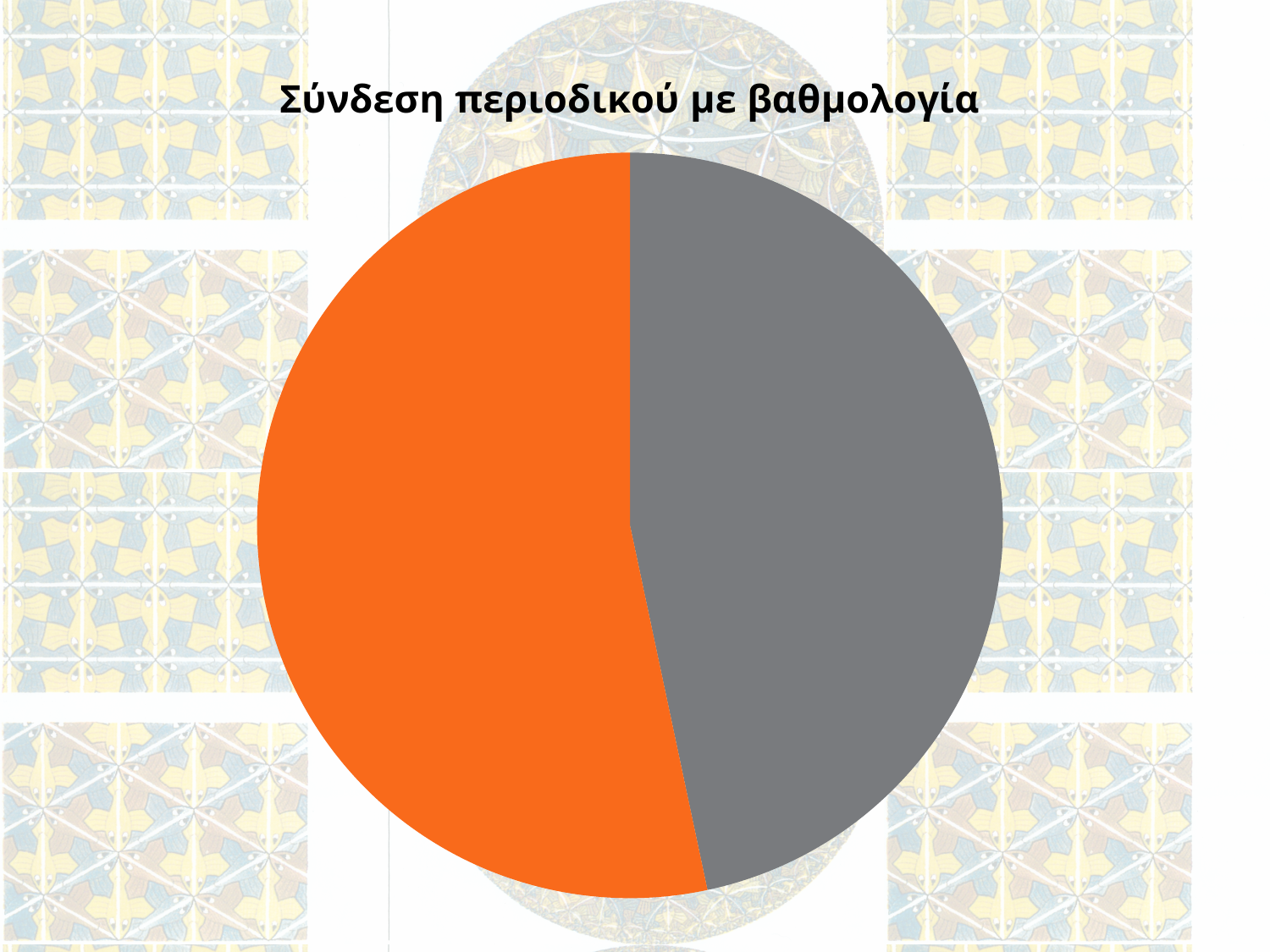
Which slice is larger, the orange one or the grey one? the orange one What two colours are used for the slices of the pie chart? orange and grey How many slices does the pie chart have? 2 What is the title of the chart? Σύνδεση περιοδικού με βαθμολογία What kind of chart is shown on the slide? pie chart